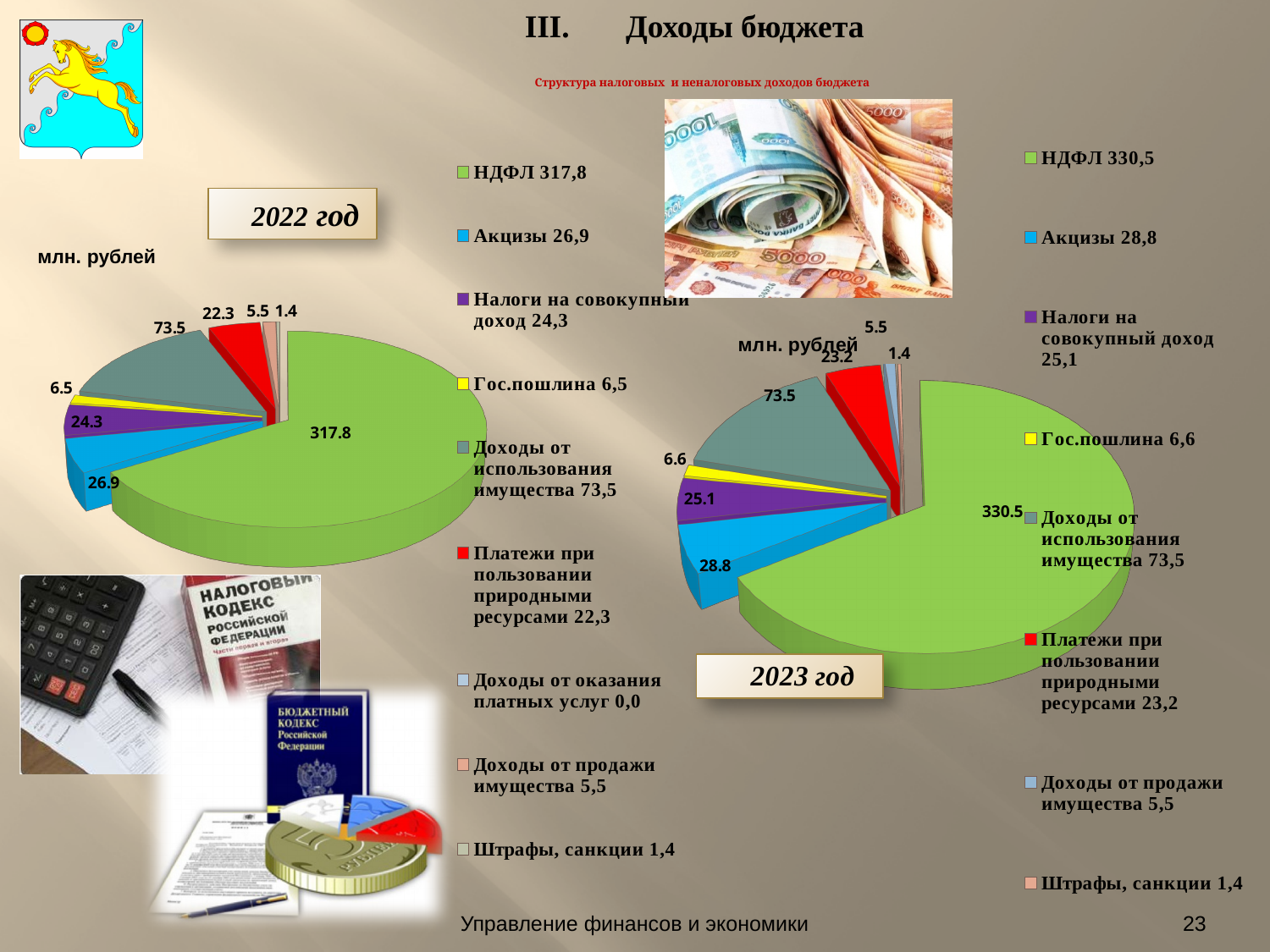
In the 2022 год pie chart, what is the difference between Доходы от использования имущества and Акцизы? 46.6 In the 2022 год pie chart, what is the value for НДФЛ? 317.8 In the 2023 год pie chart, which category has the smallest value? Штрафы, санкции How many categories does the legend of the 2022 год pie chart list? 9 In the 2023 год pie chart, what is the value for Акцизы? 28.8 In the 2022 год pie chart, what is the value for Доходы от оказания платных услуг? 0,0 In the 2022 год pie chart, which category has the largest value? НДФЛ What unit is shown next to the 2022 год pie chart? млн. рублей What type of chart is used for the 2023 год data? Pie chart In the 2023 год pie chart, what is the value for Налоги на совокупный доход? 25.1 In the 2023 год pie chart, which is larger: Платежи при пользовании природными ресурсами or Гос.пошлина? Платежи при пользовании природными ресурсами How many categories does the legend of the 2023 год pie chart list? 8